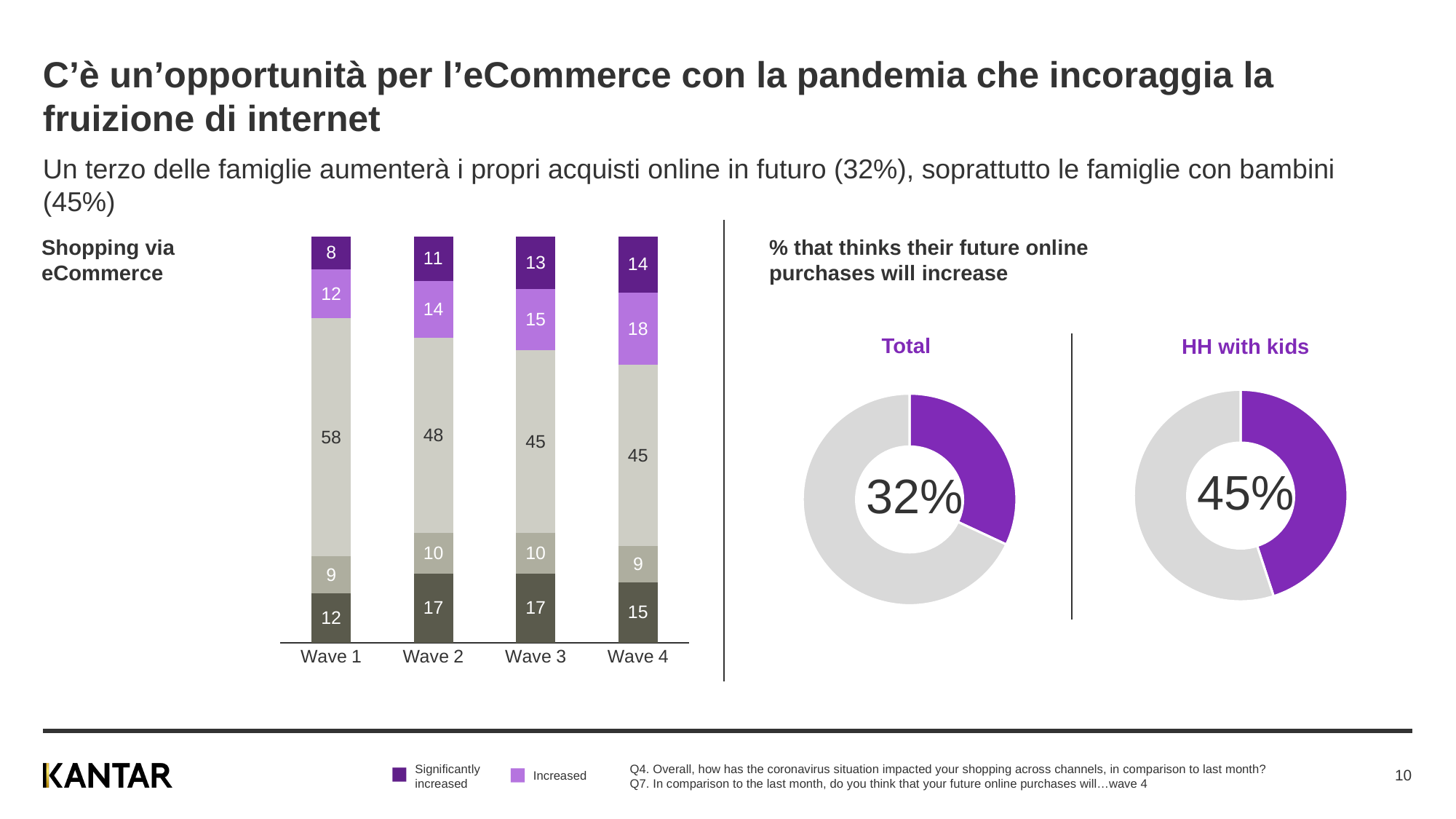
Which donut chart shows the larger value, 'Total' or 'HH with kids'? HH with kids How many series does the legend at the bottom of the slide list? 2 What kind of chart is the 'Shopping via eCommerce' chart? stacked bar chart In the 'Shopping via eCommerce' bar chart, does the 'Significantly increased' value rise or fall from Wave 1 to Wave 4? rise In the 'Shopping via eCommerce' bar chart, what is the total of the stacked bar for Wave 2? 100 In the 'Total' donut chart, what percentage thinks their future online purchases will increase? 32% In the 'Shopping via eCommerce' bar chart, what is the value of the 'Significantly increased' segment for Wave 4? 14 In the 'Shopping via eCommerce' bar chart, what is the value of the 'Increased' segment for Wave 2? 14 In the 'Shopping via eCommerce' bar chart, what is the difference between the 'Increased' values for Wave 4 and Wave 1? 6 In the 'Shopping via eCommerce' bar chart, which wave has the highest 'Significantly increased' value? Wave 4 How many waves are shown on the x axis of the 'Shopping via eCommerce' bar chart? 4 In the 'Shopping via eCommerce' bar chart, which wave has the lowest 'Increased' value? Wave 1